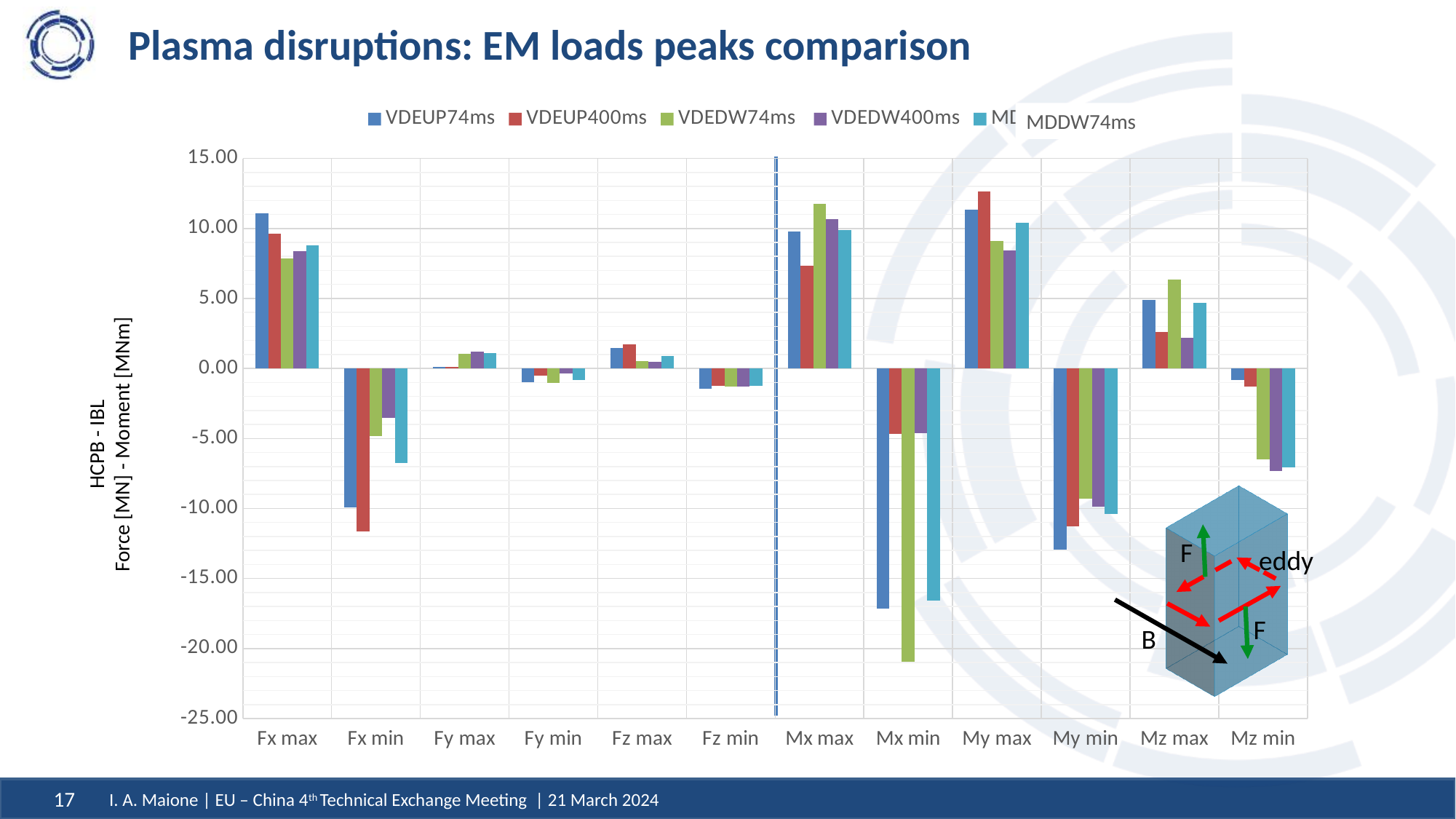
How many categories are shown along the x axis of the chart? 12 Is the value for VDEUP74ms in the Fx max category greater or less than 10.00? greater Which series has the highest value in the My max category? VDEUP400ms Which is larger, the VDEUP74ms value or the VDEUP400ms value in the Fx max category? VDEUP74ms Is the value for VDEUP400ms in the Fx min category greater or less than -10.00? less Which series has the highest value in the Fx max category? VDEUP74ms Which series has the lowest value in the Mx min category? VDEDW74ms Which series has the highest value in the Mz max category? VDEDW74ms What is the title of the slide containing the chart? Plasma disruptions: EM loads peaks comparison Is the value for VDEDW74ms in the Mx min category greater or less than -20.00? less How many series does the chart legend list? 5 What kind of chart is shown on the slide? bar chart